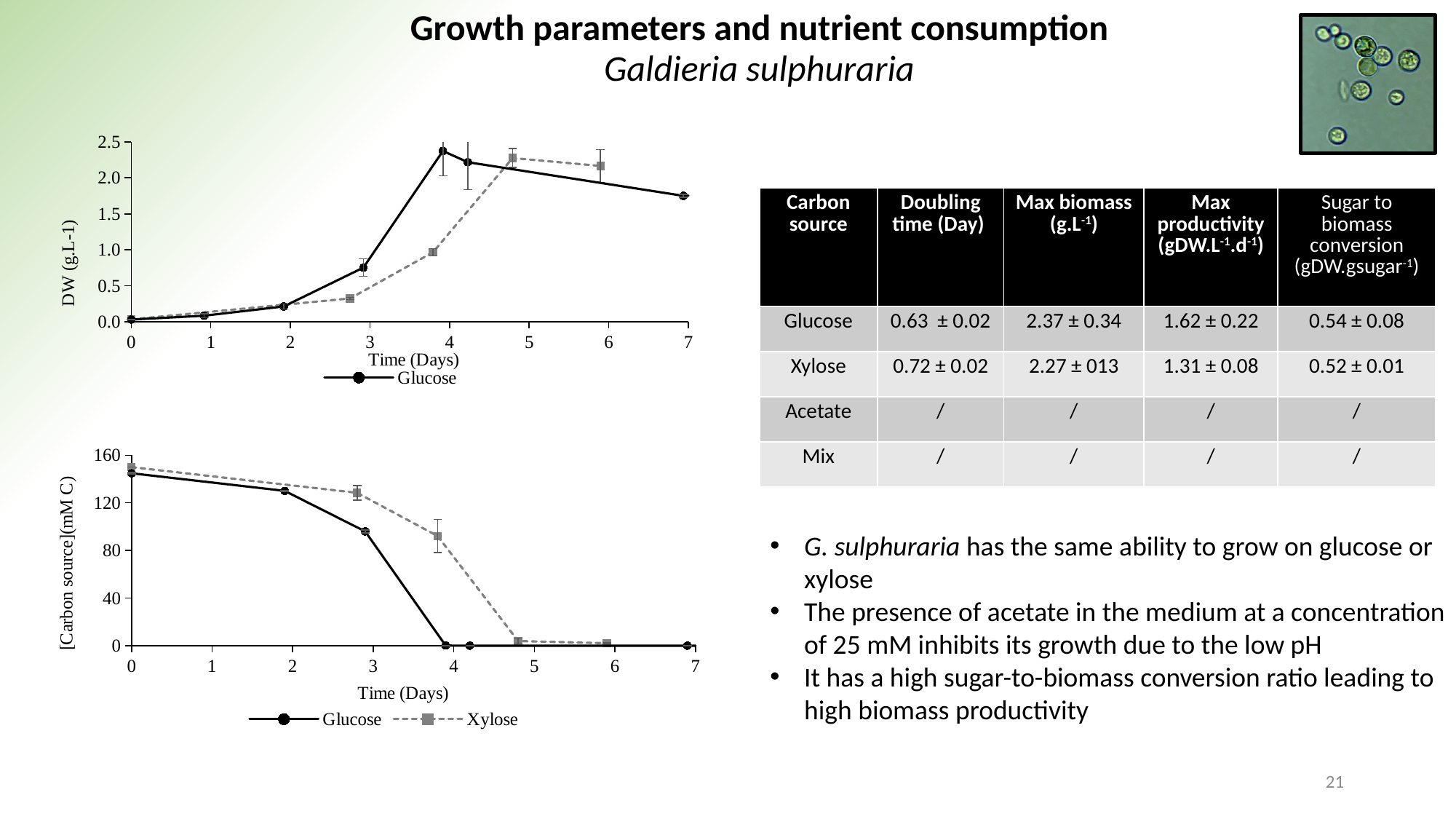
What kind of chart is the top chart on the slide? line chart What is the x-axis label of the bottom chart? Time (Days) In the top chart, is the Glucose dry weight at day 7 greater or less than 2.0? less What kind of chart is the bottom chart on the slide? line chart In the bottom chart, do the carbon source concentrations rise or fall over time? fall What is the y-axis label of the top chart? DW (g.L-1) In the bottom chart, how many series does the legend list? 2 In the top chart, is the Glucose dry weight at day 3 greater or less than 1.0? less In the bottom chart, is the Glucose concentration at day 0 greater or less than 120? greater